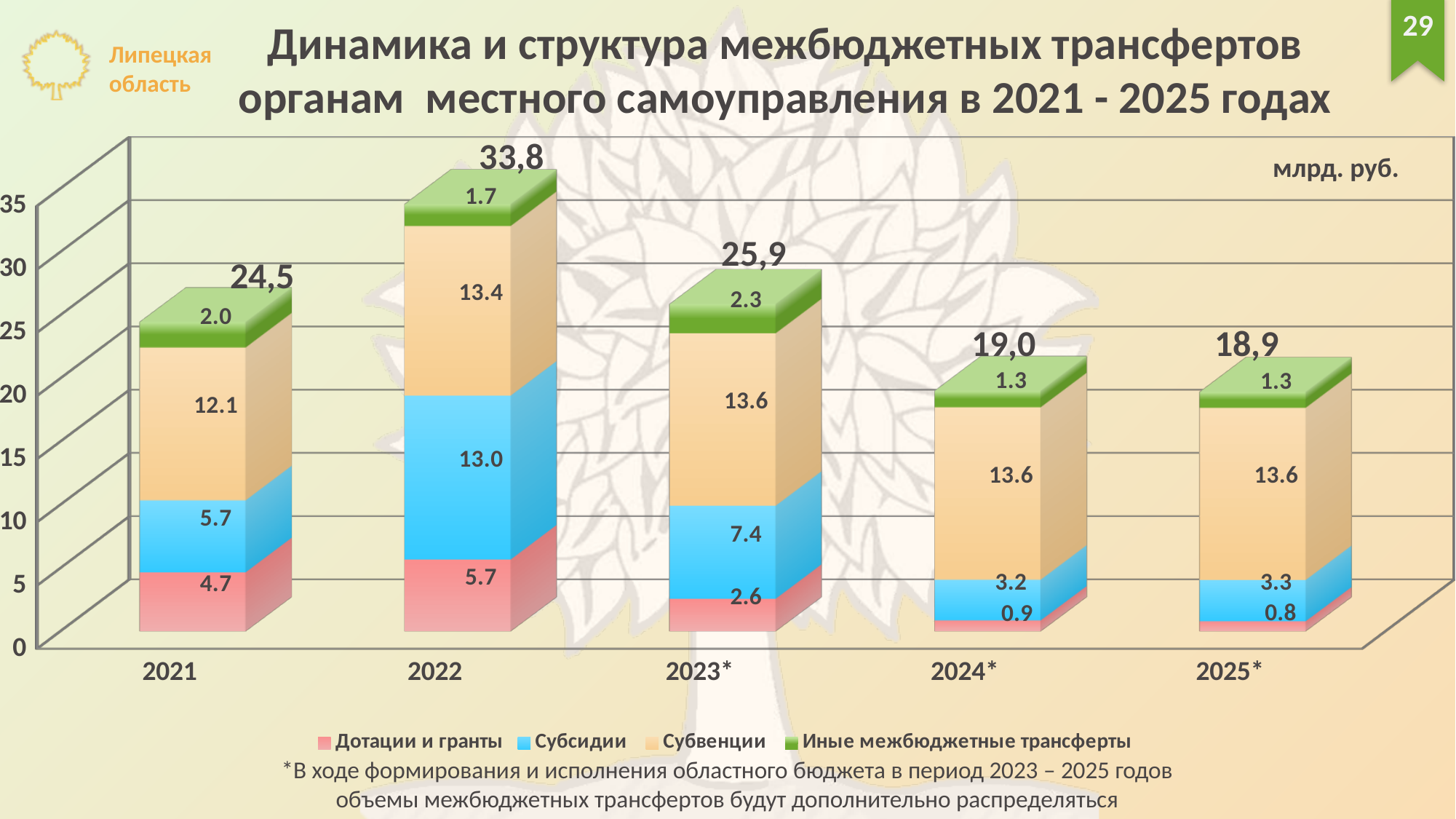
What type of chart is shown on the slide? Stacked bar chart What is the value of Дотации и гранты for 2025*? 0.8 What is the value of Субсидии for 2023*? 7.4 What is the difference between the Субсидии values for 2022 and 2021? 7.3 Which year has the lowest total of intergovernmental transfers? 2025* How many years (categories) are shown on the x axis? 5 What unit of measurement is indicated on the chart? млрд. руб. Which is larger: Иные межбюджетные трансферты in 2023* or in 2021? 2023* What is the total value of the bar for 2022? 33,8 How many series does the legend list? 4 What is the value of Субвенции for 2021? 12.1 Which year has the highest total of intergovernmental transfers? 2022